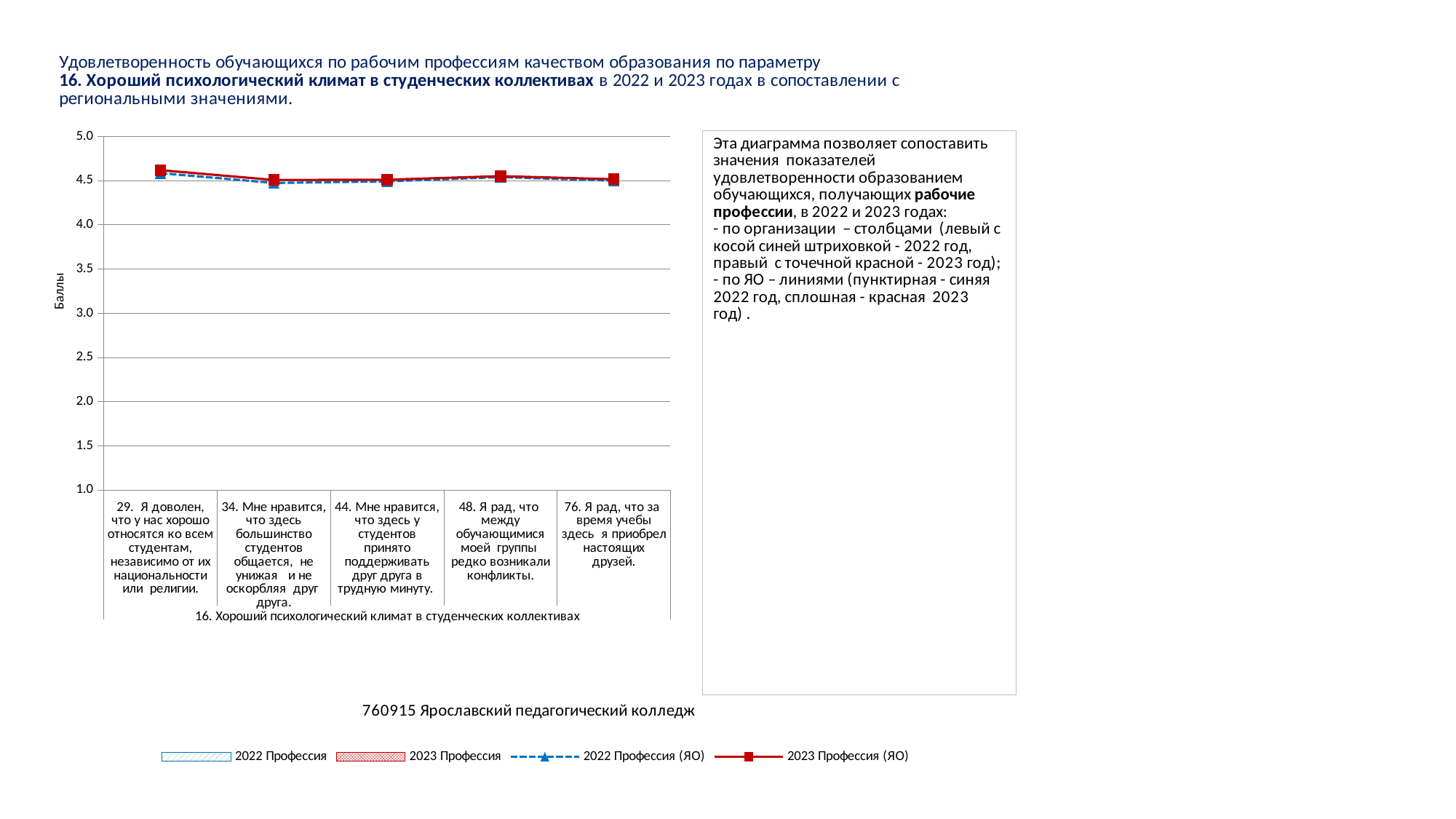
What kind of chart is plotted on the slide? line chart For category 34, which line is higher: 2022 Профессия (ЯО) or 2023 Профессия (ЯО)? 2023 Профессия (ЯО) Does the 2023 Профессия (ЯО) line rise or fall from category 29 to category 34? fall Is the value of the 2022 Профессия (ЯО) line for category 34 greater or less than 4.0? greater For which category does the 2023 Профессия (ЯО) line reach its highest value? 29 For category 29, which line is higher: 2022 Профессия (ЯО) or 2023 Профессия (ЯО)? 2023 Профессия (ЯО) Is the value of the 2023 Профессия (ЯО) line for category 29 greater or less than 4.0? greater What is the label of the vertical axis? Баллы Is the value of the 2023 Профессия (ЯО) line for category 76 greater or less than 3.5? greater How many series does the chart legend list? 4 How many categories are shown on the x axis of the chart? 5 What colour is the 2023 Профессия (ЯО) line in the legend? red